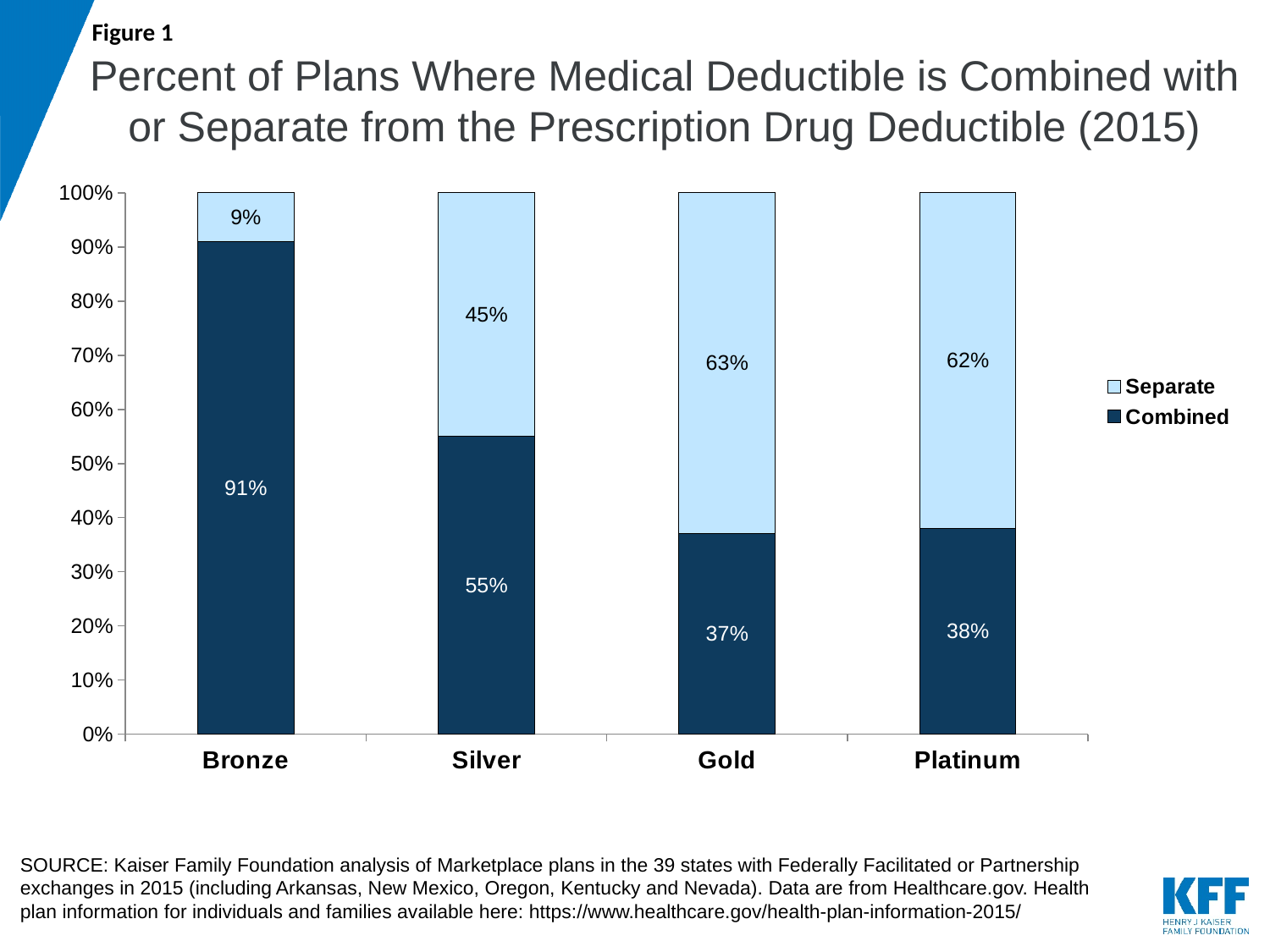
Which is larger: the Separate share for Gold plans or the Separate share for Silver plans? Gold What percent of Bronze plans have a Combined deductible? 91% What percent of Silver plans have a Separate deductible? 45% What is the difference between the Combined percentages for Bronze and Silver plans? 36 percentage points How many metal levels are shown on the x axis? 4 Which metal level has the lowest percent of plans with a Separate deductible? Bronze How many series does the legend list? 2 Which metal level has the highest percent of plans with a Combined deductible? Bronze What percent of Gold plans have a Combined deductible? 37% What kind of chart is shown on the slide? Stacked bar chart Which legend entry is shown in the dark blue colour? Combined What percent of Platinum plans have a Separate deductible? 62%